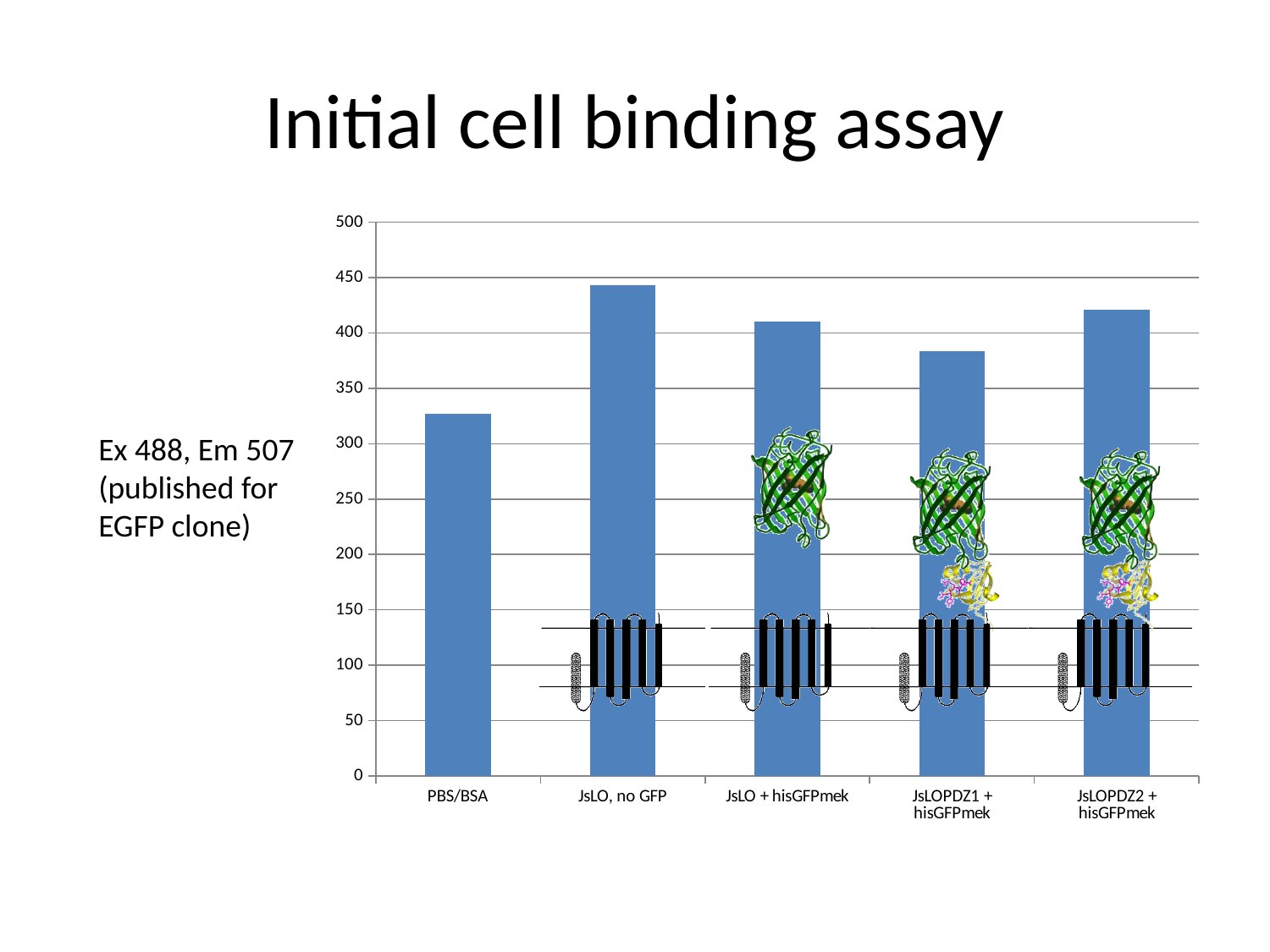
Which category has the lowest bar in the chart? PBS/BSA Is the value for JsLO + hisGFPmek greater or less than 450? less Is the value for JsLO, no GFP greater or less than 400? greater Is the value for PBS/BSA greater or less than 350? less What kind of chart is shown on the slide? bar chart How many categories are shown on the x axis of the chart? 5 Which category has the highest bar in the chart? JsLO, no GFP Which is larger, the value for JsLO, no GFP or the value for JsLOPDZ1 + hisGFPmek? JsLO, no GFP What is the title of the slide containing the chart? Initial cell binding assay Which is larger, the value for PBS/BSA or the value for JsLOPDZ2 + hisGFPmek? JsLOPDZ2 + hisGFPmek